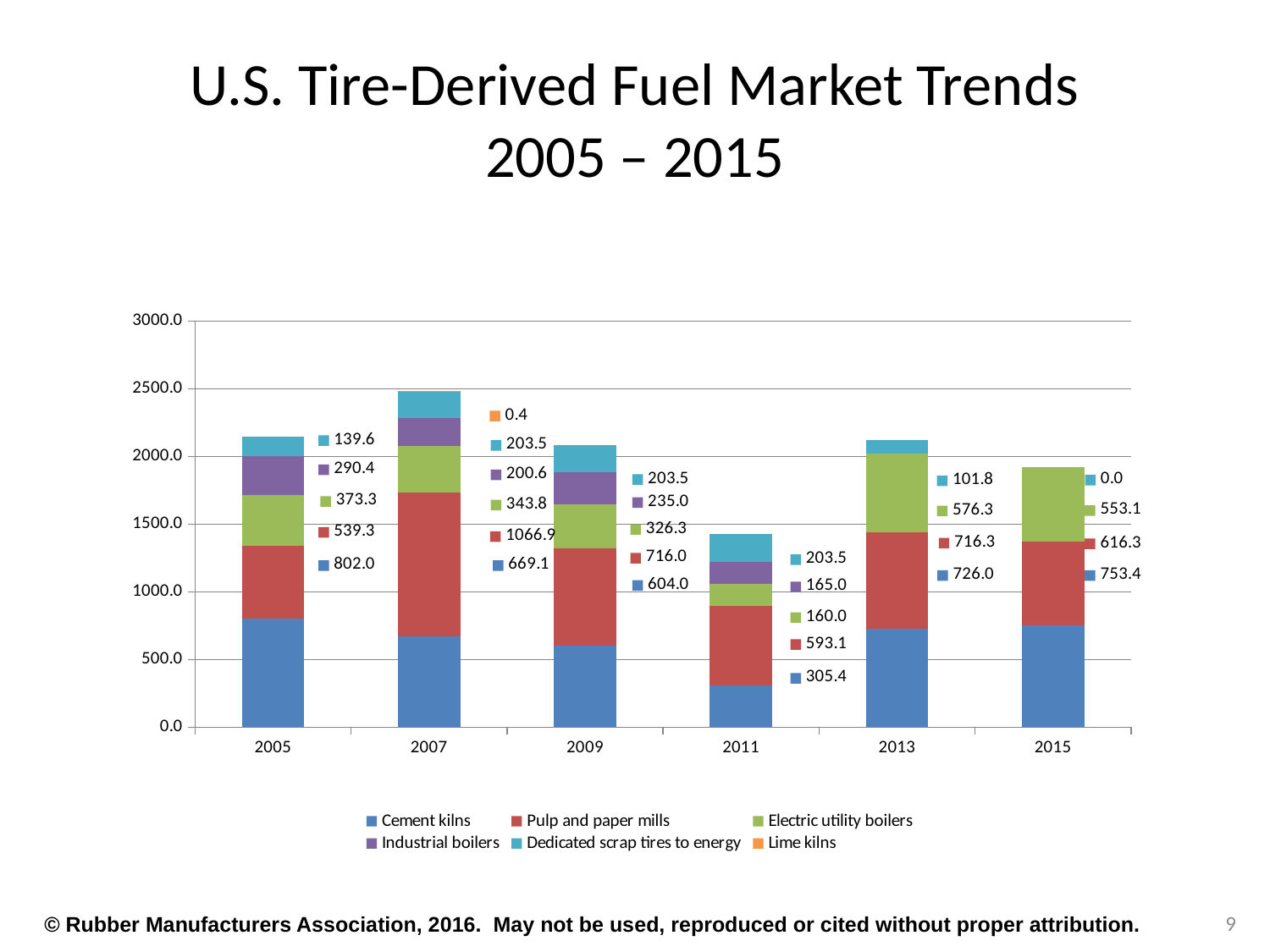
What is the total of the stacked bar for 2011? 1427.0 Which year has the lowest value for Cement kilns? 2011 What is the value for Pulp and paper mills in 2007? 1066.9 What is the value for Dedicated scrap tires to energy in 2015? 0.0 Which year has the highest value for Pulp and paper mills? 2007 What kind of chart is shown on the slide? Stacked bar chart What is the value for Electric utility boilers in 2013? 576.3 What is the value for Cement kilns in 2005? 802.0 How many years are shown on the x axis? 6 What is the difference between the Cement kilns values in 2015 and 2011? 448.0 How many series does the legend list? 6 Which is larger in 2013: Cement kilns or Pulp and paper mills? Cement kilns